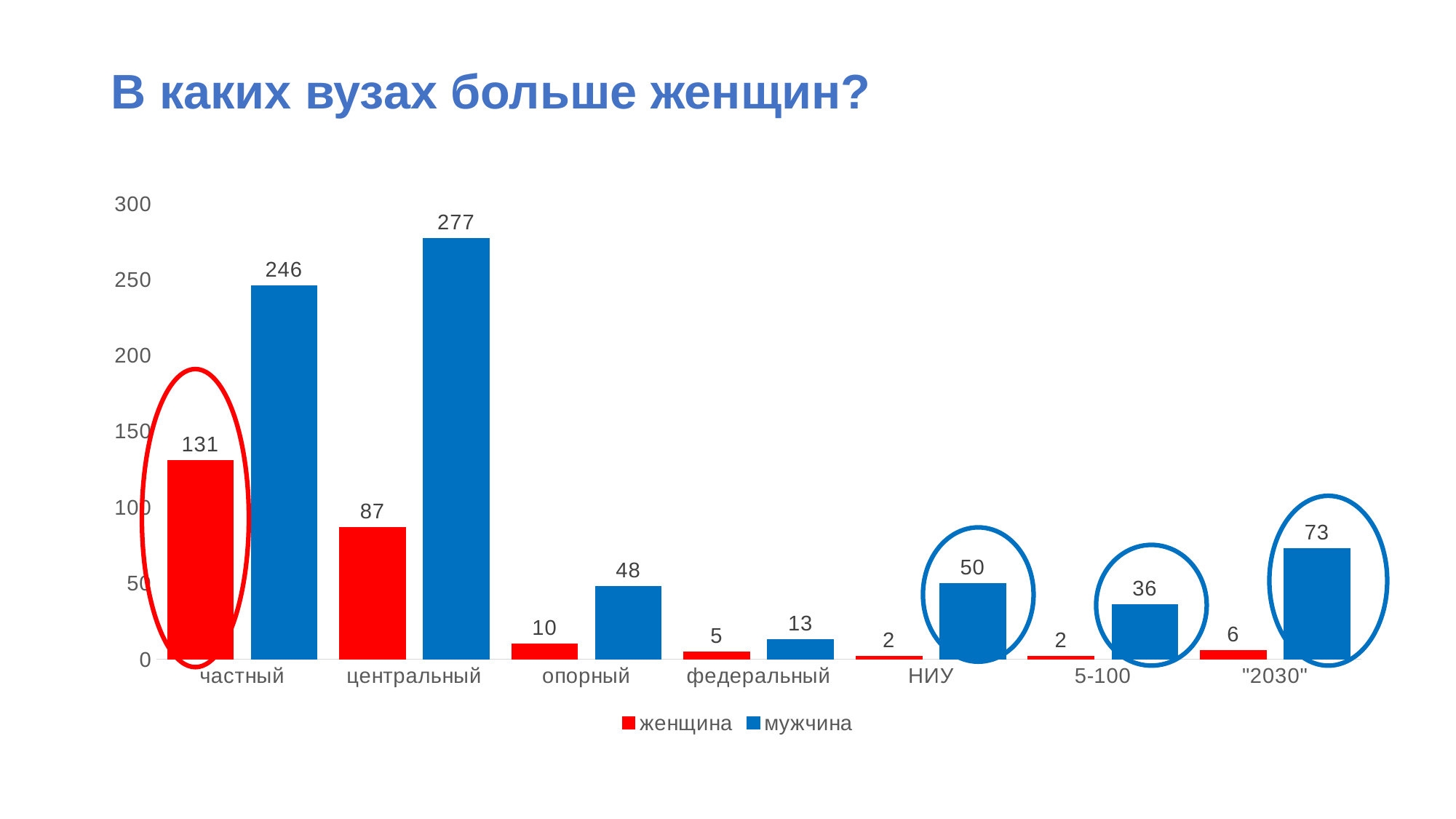
What is the difference between the мужчина and женщина values in the частный category? 115 How many series does the legend list? 2 Which category has the lowest value for мужчина? федеральный What is the value for женщина in the частный category? 131 What is the value for мужчина in the центральный category? 277 What kind of chart is shown on the slide? bar chart Is the value for мужчина in the опорный category greater or less than 50? less What colour represents the женщина series? red Which category has the highest value for мужчина? центральный How many categories are shown on the x axis? 7 Which is larger in the центральный category: женщина or мужчина? мужчина What is the value for мужчина in the "2030" category? 73